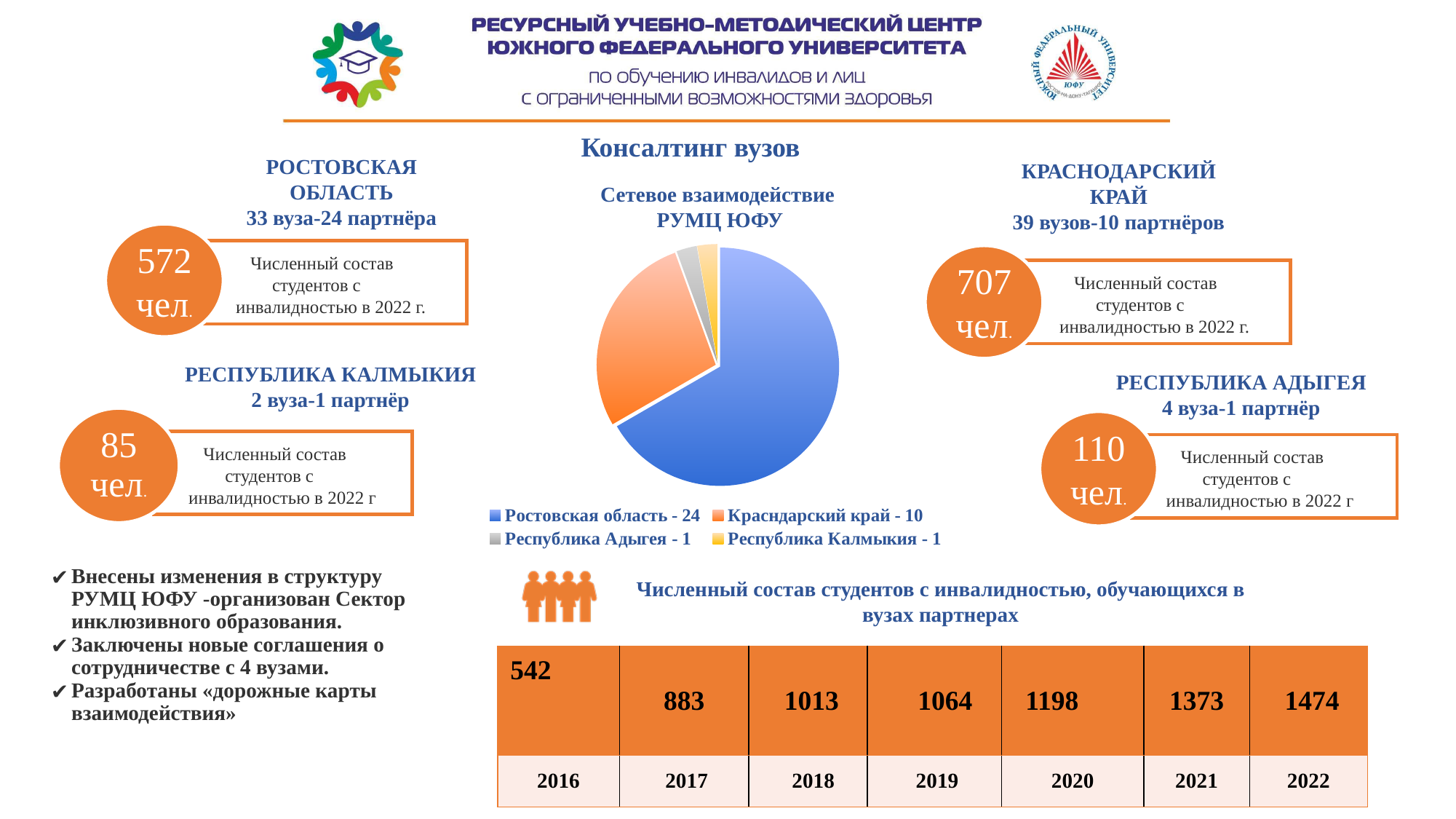
What kind of chart is shown under the heading "Сетевое взаимодействие РУМЦ ЮФУ"? pie chart In the pie chart "Сетевое взаимодействие РУМЦ ЮФУ", what is the difference between the values for Ростовская область and Краснодарский край? 14 What is the sum of all four values shown in the legend of the pie chart "Сетевое взаимодействие РУМЦ ЮФУ"? 36 In the pie chart "Сетевое взаимодействие РУМЦ ЮФУ", what value is given for Республика Адыгея? 1 What is the title of the pie chart on the slide? Сетевое взаимодействие РУМЦ ЮФУ In the pie chart "Сетевое взаимодействие РУМЦ ЮФУ", what value is given for Краснодарский край? 10 In the pie chart "Сетевое взаимодействие РУМЦ ЮФУ", what value is given for Ростовская область? 24 How many categories (slices) does the pie chart "Сетевое взаимодействие РУМЦ ЮФУ" have? 4 What colour is the slice for Ростовская область in the pie chart "Сетевое взаимодействие РУМЦ ЮФУ"? blue In the pie chart "Сетевое взаимодействие РУМЦ ЮФУ", which is larger: the value for Краснодарский край or for Республика Калмыкия? Краснодарский край Which category has the largest slice in the pie chart "Сетевое взаимодействие РУМЦ ЮФУ"? Ростовская область Which two categories share the smallest value in the pie chart "Сетевое взаимодействие РУМЦ ЮФУ"? Республика Адыгея and Республика Калмыкия